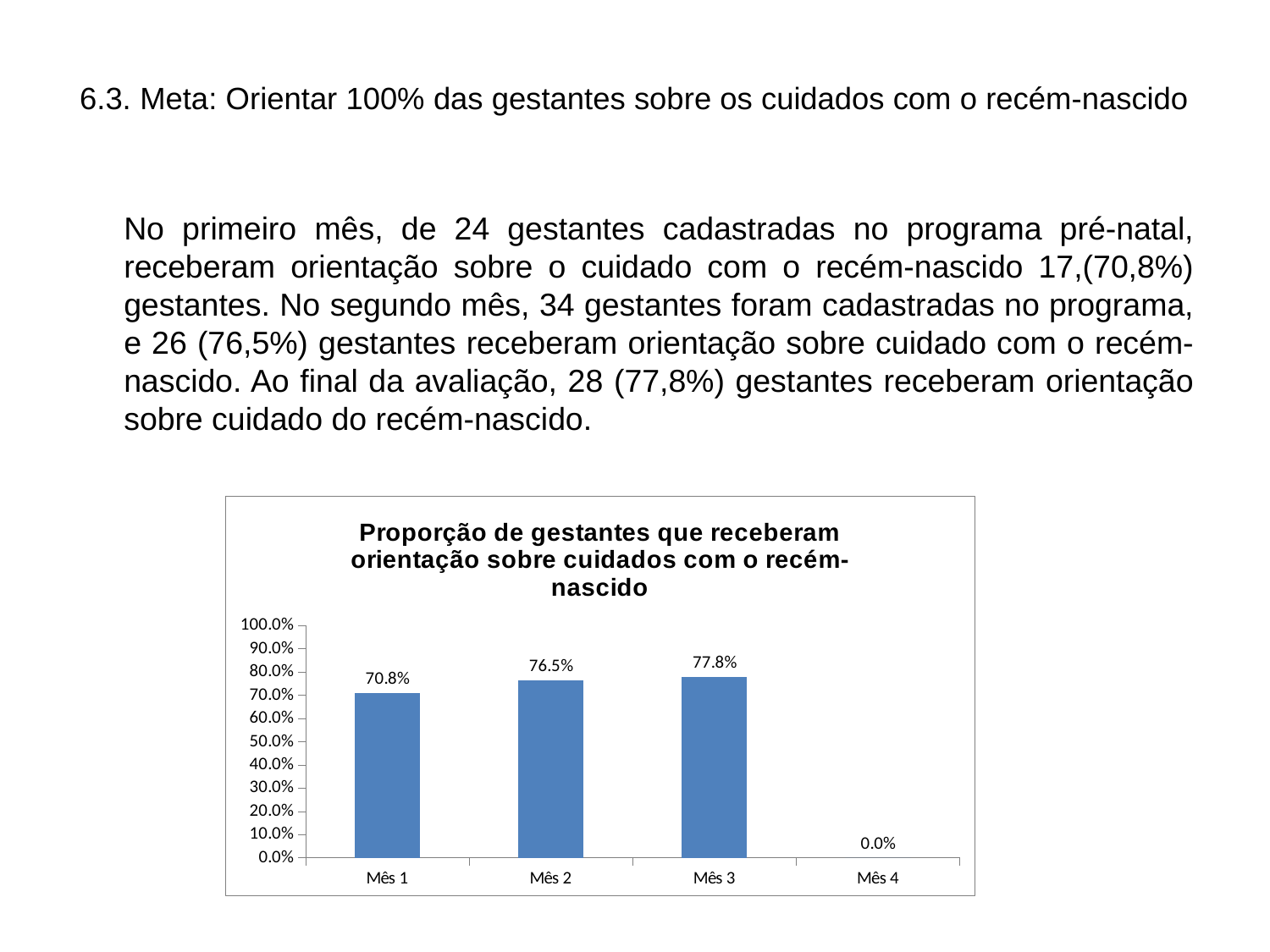
Which month has the lowest value? Mês 4 What is the value for Mês 1? 70.8% What is the value for Mês 3? 77.8% What is the value for Mês 4? 0.0% What kind of chart is shown? bar chart Which month has the highest value? Mês 3 What is the difference between the values for Mês 2 and Mês 1? 5.7% What is the value for Mês 2? 76.5% What is the title of the chart? Proporção de gestantes que receberam orientação sobre cuidados com o recém-nascido Is the value for Mês 1 greater or less than 80.0%? less How many months are shown on the x axis? 4 Which is larger, the value for Mês 1 or the value for Mês 2? Mês 2